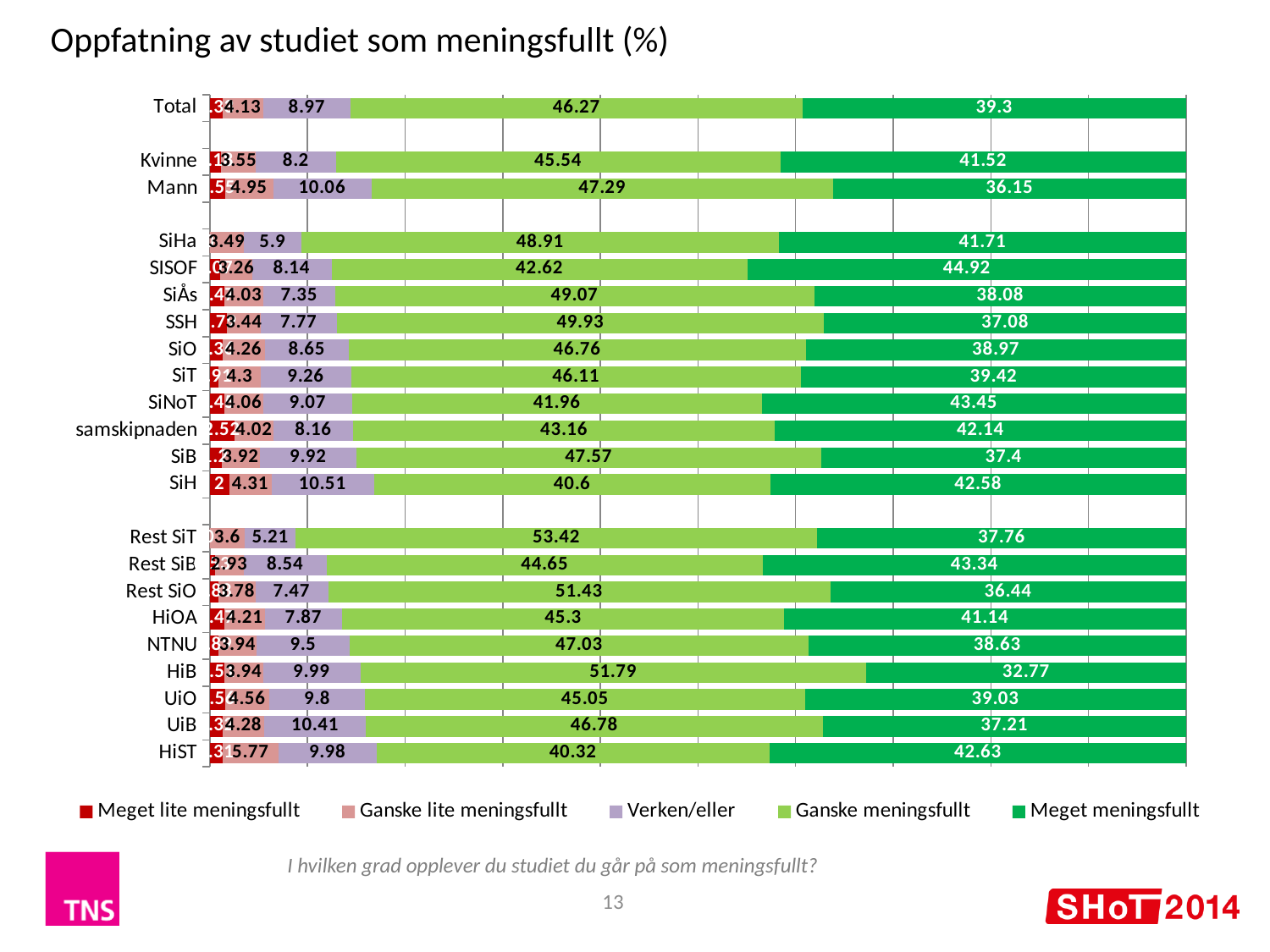
What is the value for "Ganske lite meningsfullt" for HiST? 5.77 Which category has the highest value for "Ganske meningsfullt"? Rest SiT How many series does the legend list? 5 Which category has the highest value for "Meget meningsfullt"? SISOF What is the value for "Meget meningsfullt" for Total? 39.3 Which has a larger "Ganske meningsfullt" value, SiÅs or SiNoT? SiÅs What is the value for "Ganske meningsfullt" for Mann? 47.29 How many categories are shown on the y axis? 22 What kind of chart is shown? Stacked bar chart What is the difference between the "Meget meningsfullt" values for Kvinne and Mann? 5.37 What is the value for "Verken/eller" for SiH? 10.51 Which category has the lowest value for "Meget meningsfullt"? HiB